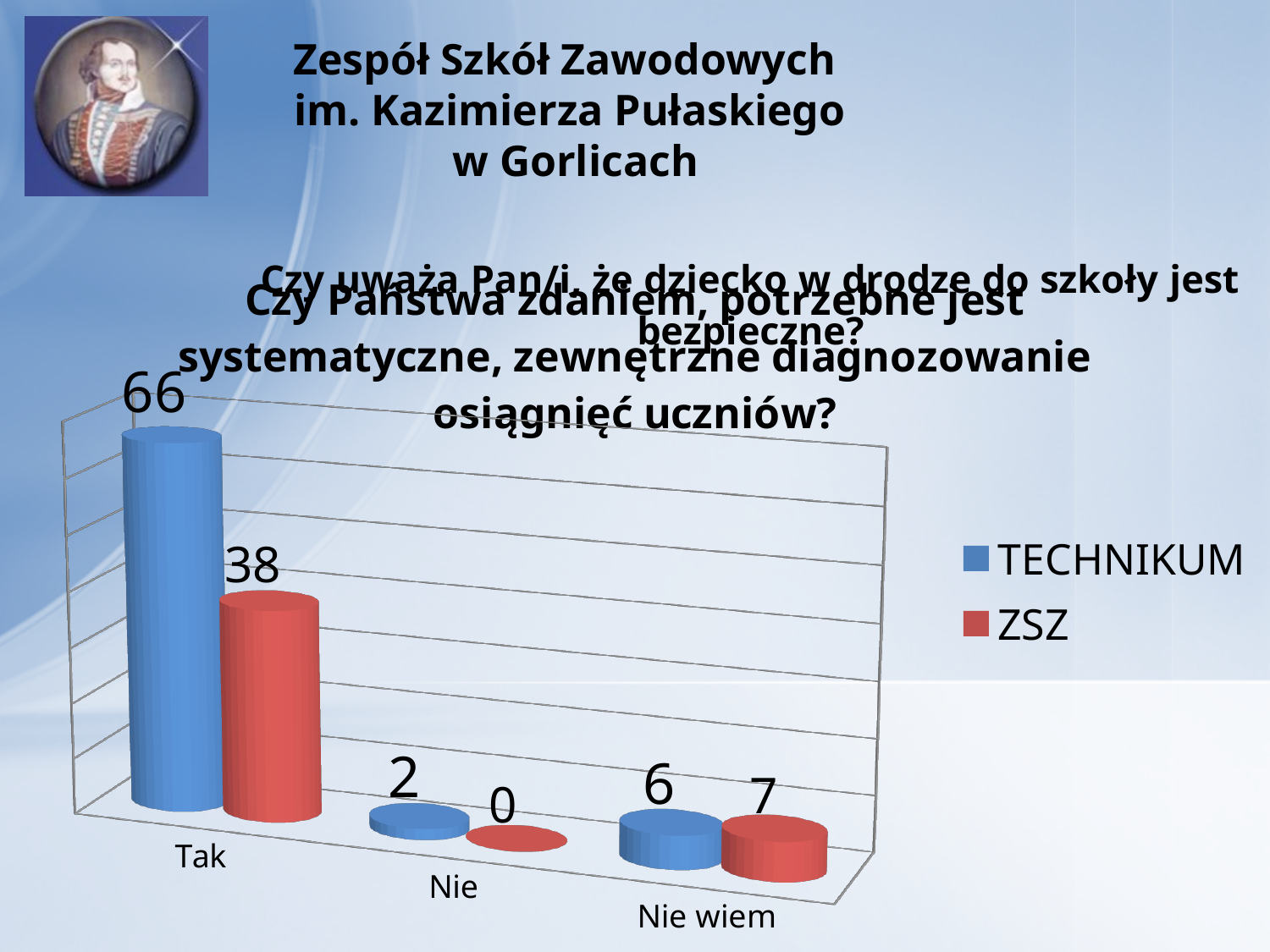
Which category has the lowest value for ZSZ? Nie What is the difference between the TECHNIKUM and ZSZ values in the Tak category? 28 How many categories are shown on the x axis? 3 What kind of chart is shown on the slide? Bar chart What is the value for TECHNIKUM in the Tak category? 66 What is the value for TECHNIKUM in the Nie category? 2 What is the value for ZSZ in the Tak category? 38 In the Nie wiem category, which series has the larger value, TECHNIKUM or ZSZ? ZSZ Which category has the highest value for TECHNIKUM? Tak How many series does the legend list? 2 What is the value for ZSZ in the Nie category? 0 What is the value for ZSZ in the Nie wiem category? 7